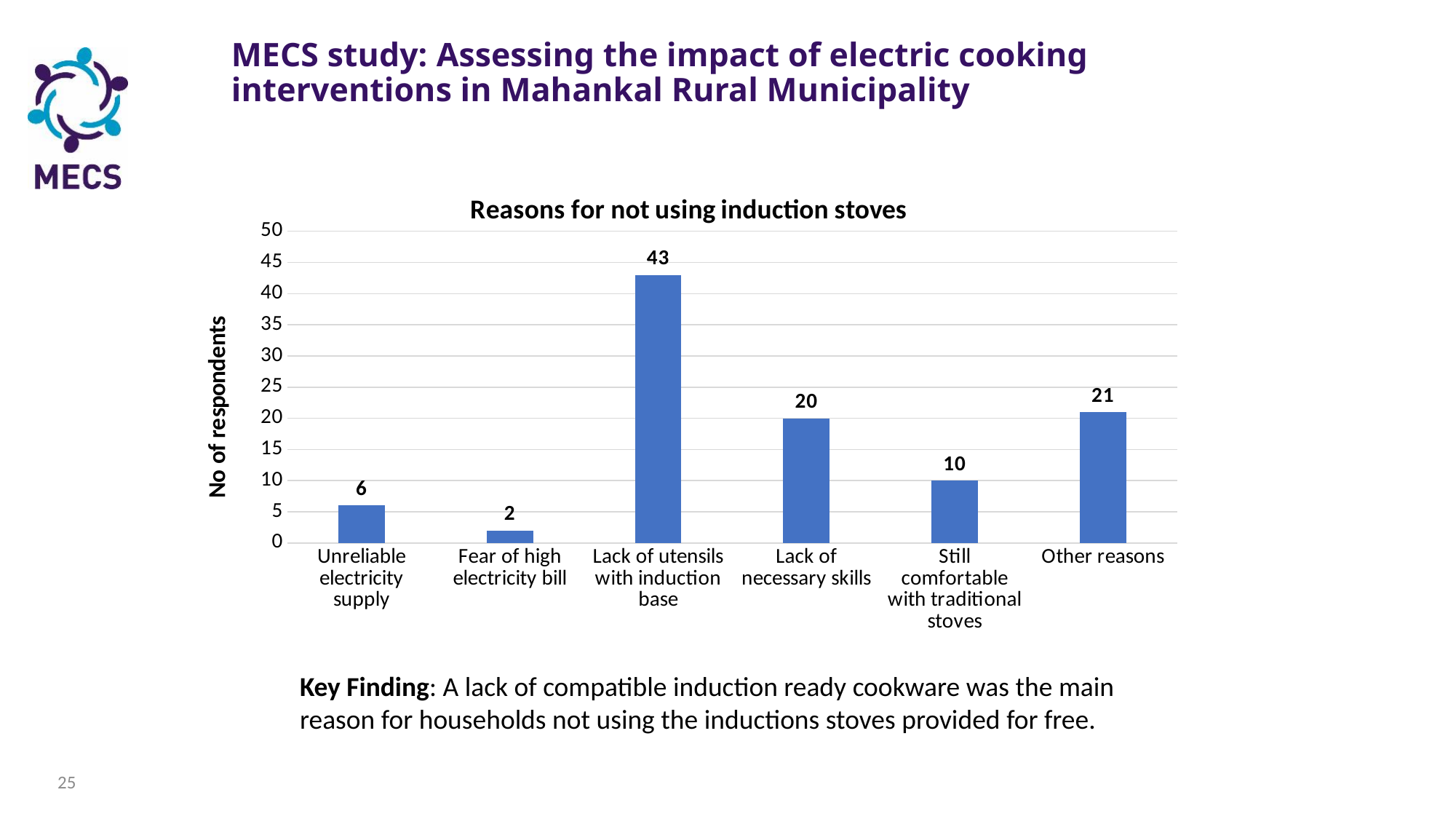
What is the number of respondents for 'Other reasons'? 21 Is the value for 'Other reasons' greater or less than 25? less Which reason has the lowest number of respondents? Fear of high electricity bill What is the number of respondents for 'Still comfortable with traditional stoves'? 10 What type of chart is shown on the slide? Bar chart What is the title of the chart? Reasons for not using induction stoves Which has more respondents: 'Unreliable electricity supply' or 'Still comfortable with traditional stoves'? Still comfortable with traditional stoves What is the number of respondents for 'Lack of utensils with induction base'? 43 Which reason has the highest number of respondents? Lack of utensils with induction base What is the number of respondents for 'Fear of high electricity bill'? 2 How many reasons (categories) are shown in the chart? 6 What is the difference in respondents between 'Lack of utensils with induction base' and 'Lack of necessary skills'? 23